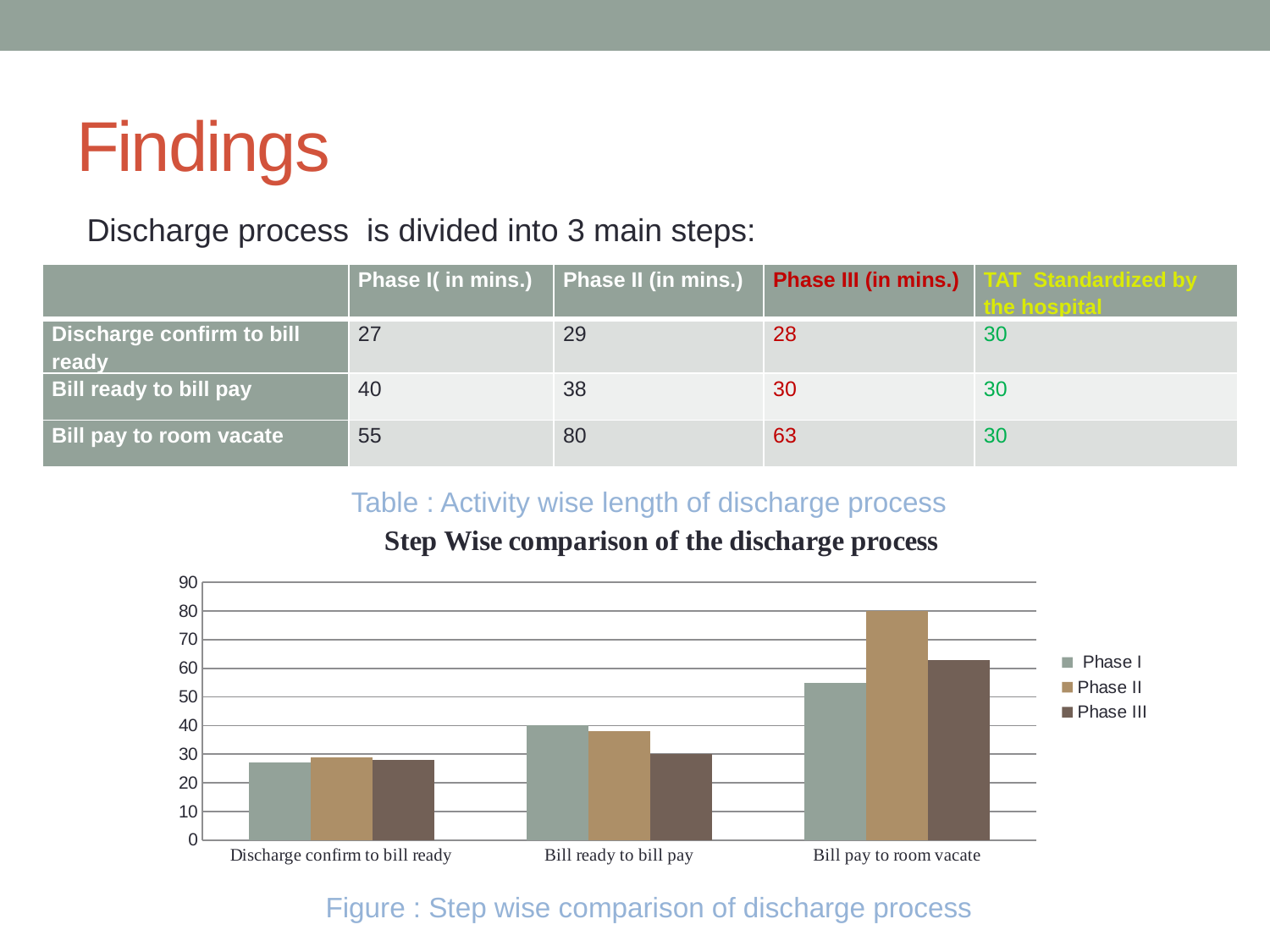
What is the Phase I value for Bill ready to bill pay? 40 What type of chart is shown on the slide? bar chart What is the Phase II value for Bill pay to room vacate? 80 How many series does the chart legend list? 3 Is the Phase III value for Bill pay to room vacate greater or less than 60? greater For Bill pay to room vacate, which is larger: Phase I or Phase II? Phase II How many categories are shown on the x axis of the chart? 3 Which category has the lowest Phase I value? Discharge confirm to bill ready What is the title of the chart? Step Wise comparison of the discharge process What is the Phase III value for Bill ready to bill pay? 30 Which category has the highest Phase II value? Bill pay to room vacate Do the Phase I values rise or fall from Discharge confirm to bill ready to Bill pay to room vacate? rise